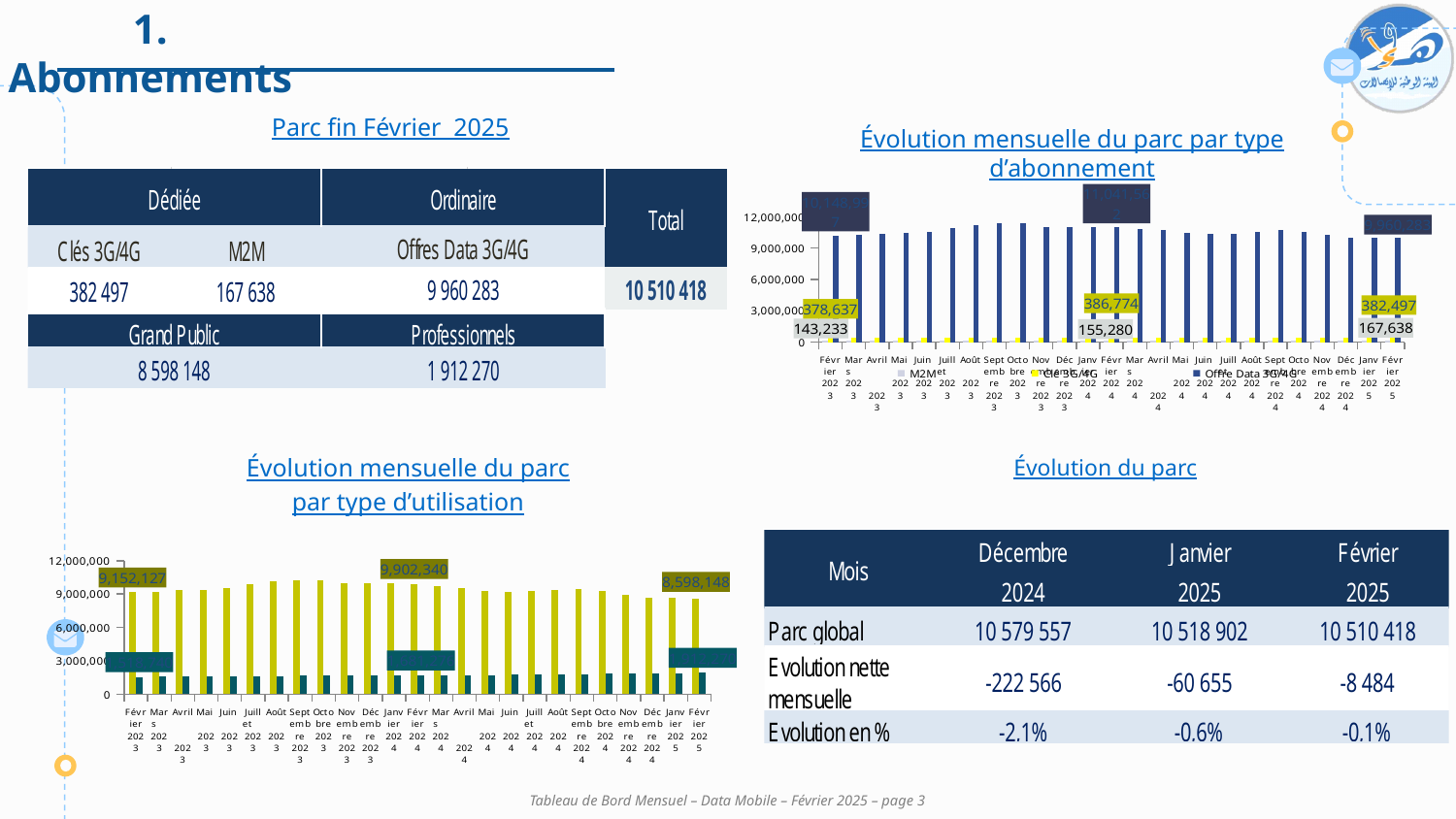
In the chart 'Évolution mensuelle du parc par type d'abonnement', which is larger: the Clés 3G/4G value for Février 2024 or for Février 2025? Février 2024 In the chart 'Évolution mensuelle du parc par type d'utilisation', how many months are shown on the x axis? 25 What kind of chart is 'Évolution mensuelle du parc par type d'utilisation'? bar chart In the chart 'Évolution mensuelle du parc par type d'abonnement', what is the value for Clés 3G/4G in Février 2025? 382,497 In the chart 'Évolution mensuelle du parc par type d'utilisation', what is the Grand Public value for Février 2024? 9,902,340 In the chart 'Évolution mensuelle du parc par type d'abonnement', what is the difference between the M2M values for Février 2025 and Février 2023? 24,405 In the chart 'Évolution mensuelle du parc par type d'utilisation', what is the difference between the Grand Public values for Février 2024 and Février 2025? 1,304,192 In the chart 'Évolution mensuelle du parc par type d'utilisation', is the Professionnels value for Février 2025 greater or less than 3,000,000? less In the chart 'Évolution mensuelle du parc par type d'abonnement', what is the value for M2M in Février 2023? 143,233 In the chart 'Évolution mensuelle du parc par type d'abonnement', how many series does the legend list? 3 What kind of chart is 'Évolution mensuelle du parc par type d'abonnement'? bar chart In the chart 'Évolution mensuelle du parc par type d'abonnement', is the Offre Data 3G/4G value for Février 2025 greater or less than 9,000,000? greater